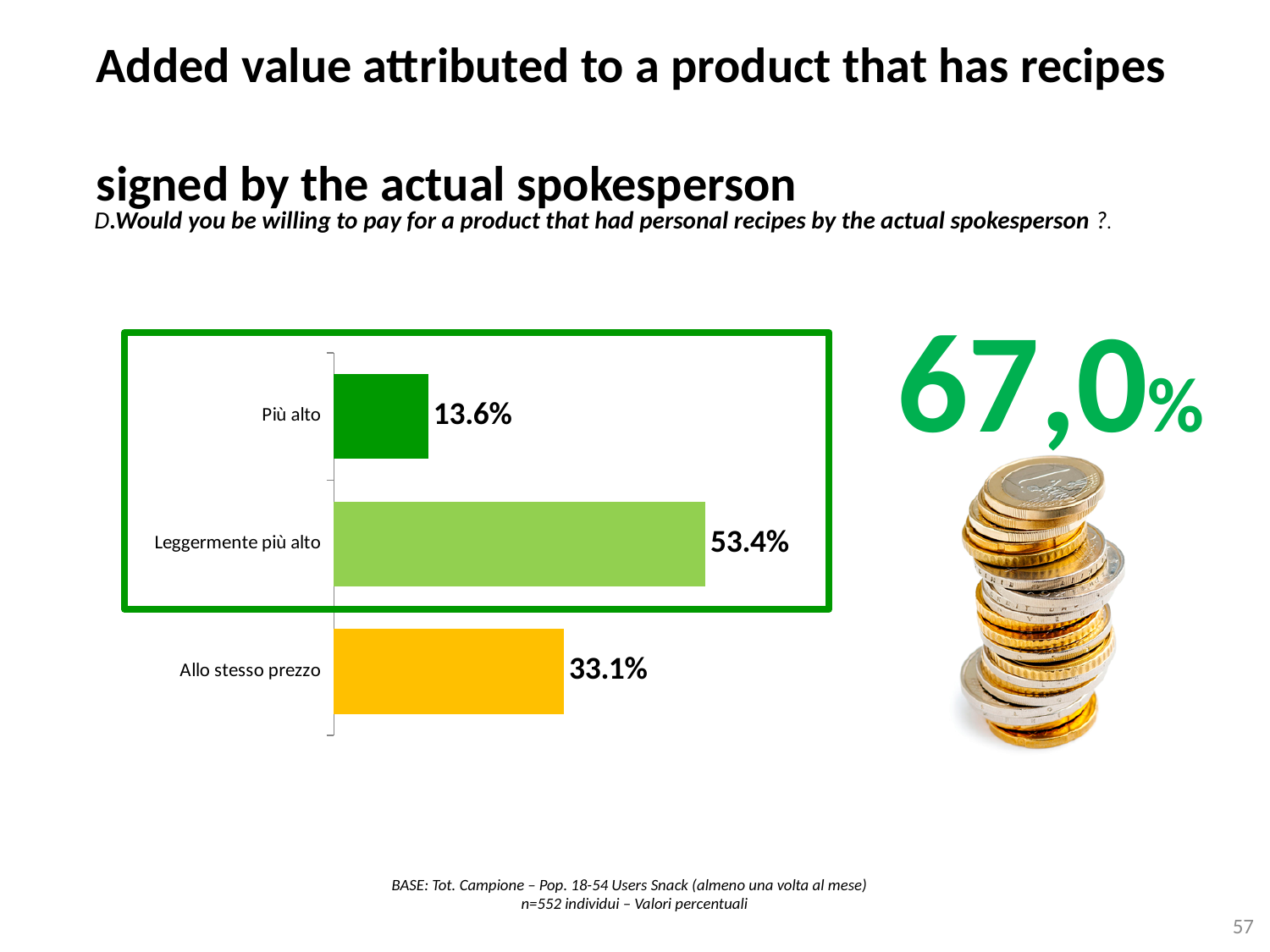
What is the difference between the values for "Leggermente più alto" and "Allo stesso prezzo"? 20.3% Which category has the lowest value? Più alto What is the value for "Allo stesso prezzo"? 33.1% What is the combined value of the two categories enclosed in the green box ("Più alto" and "Leggermente più alto")? 67.0% Which is larger, the value for "Allo stesso prezzo" or the value for "Più alto"? Allo stesso prezzo What is the difference between the values for "Allo stesso prezzo" and "Più alto"? 19.5% How many categories are shown in the chart? 3 What is the value for "Più alto"? 13.6% What kind of chart is shown on the slide? Bar chart What large percentage figure is printed to the right of the chart? 67,0% Which category has the highest value? Leggermente più alto What is the value for "Leggermente più alto"? 53.4%